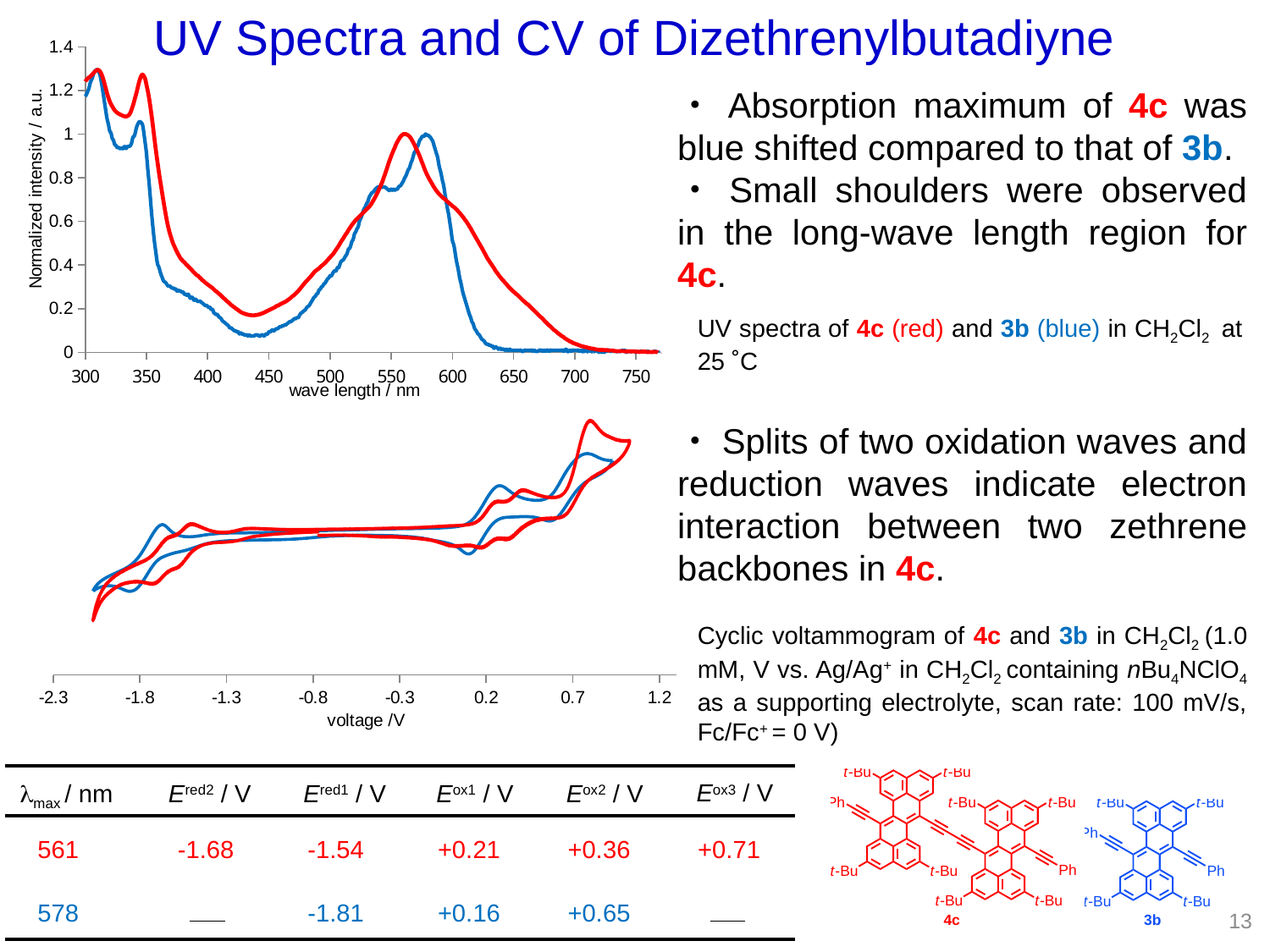
In the UV spectra chart, is the normalized intensity of the blue curve (3b) at 400 nm greater or less than 0.4? less In the UV spectra chart, which curve has the higher normalized intensity at 600 nm, the red curve (4c) or the blue curve (3b)? red curve (4c) In the UV spectra chart, is the normalized intensity of the red curve (4c) at 550 nm greater or less than 0.8? greater In the UV spectra chart, what is the label of the x axis? wave length / nm In the cyclic voltammogram chart, what is the highest value shown on the voltage axis? 1.2 In the UV spectra chart, is the normalized intensity of the red curve (4c) at 700 nm greater or less than 0.2? less How many curves are plotted in the UV spectra chart? 2 In the UV spectra chart, which curve reaches its main long-wavelength absorption maximum at the longer wavelength, the red curve (4c) or the blue curve (3b)? blue curve (3b) What kind of chart is the cyclic voltammogram at the bottom left of the slide? line chart What kind of chart is the UV spectra chart at the top left of the slide? line chart In the UV spectra chart, what is the label of the y axis? Normalized intensity / a.u.